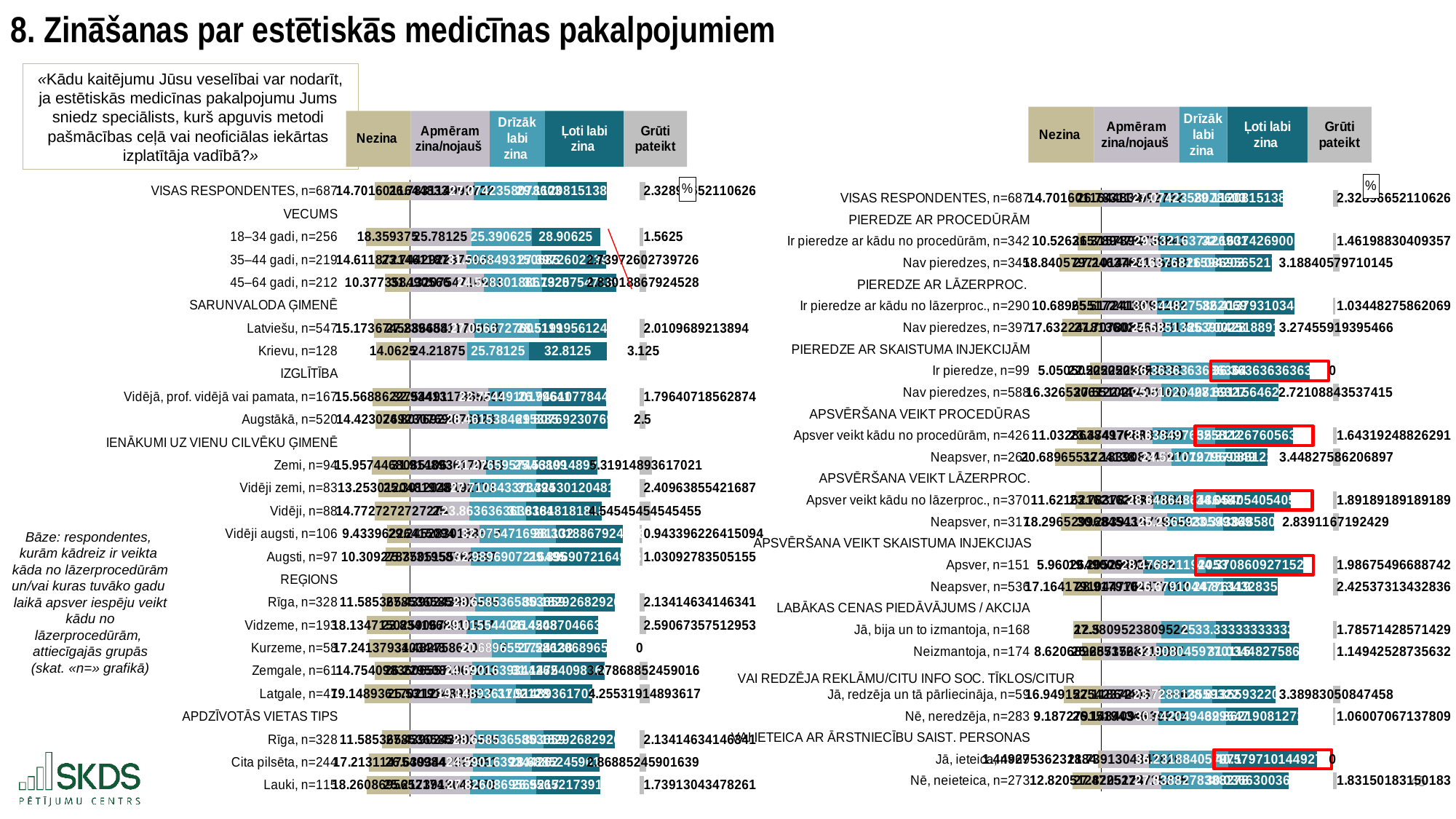
In the left chart, what is the 'Ļoti labi zina' value for 'Krievu, n=128'? 32.8125 In the left chart, which has the larger 'Ļoti labi zina' value: 'Krievu, n=128' or '18–34 gadi, n=256'? Krievu, n=128 In the right chart, what is the 'Grūti pateikt' value for 'Jā, bija un to izmantoja, n=168'? 1.78571428571429 In the left chart, what is the 'Ļoti labi zina' value for '18–34 gadi, n=256'? 28.90625 In the left chart, what is the 'Grūti pateikt' value for 'Krievu, n=128'? 3.125 In the left chart, what is the difference between the 'Ļoti labi zina' values for 'Krievu, n=128' and '18–34 gadi, n=256'? 3.90625 In the right chart, what is the 'Grūti pateikt' value for 'Ir pieredze, n=99'? 0 In the left chart, what is the 'Grūti pateikt' value for '18–34 gadi, n=256'? 1.5625 What is the first entry in the legend? Nezina How many series does the legend list? 5 What kind of chart is used on this slide? stacked bar chart In the left chart, what is the 'Nezina' value for 'Krievu, n=128'? 14.0625